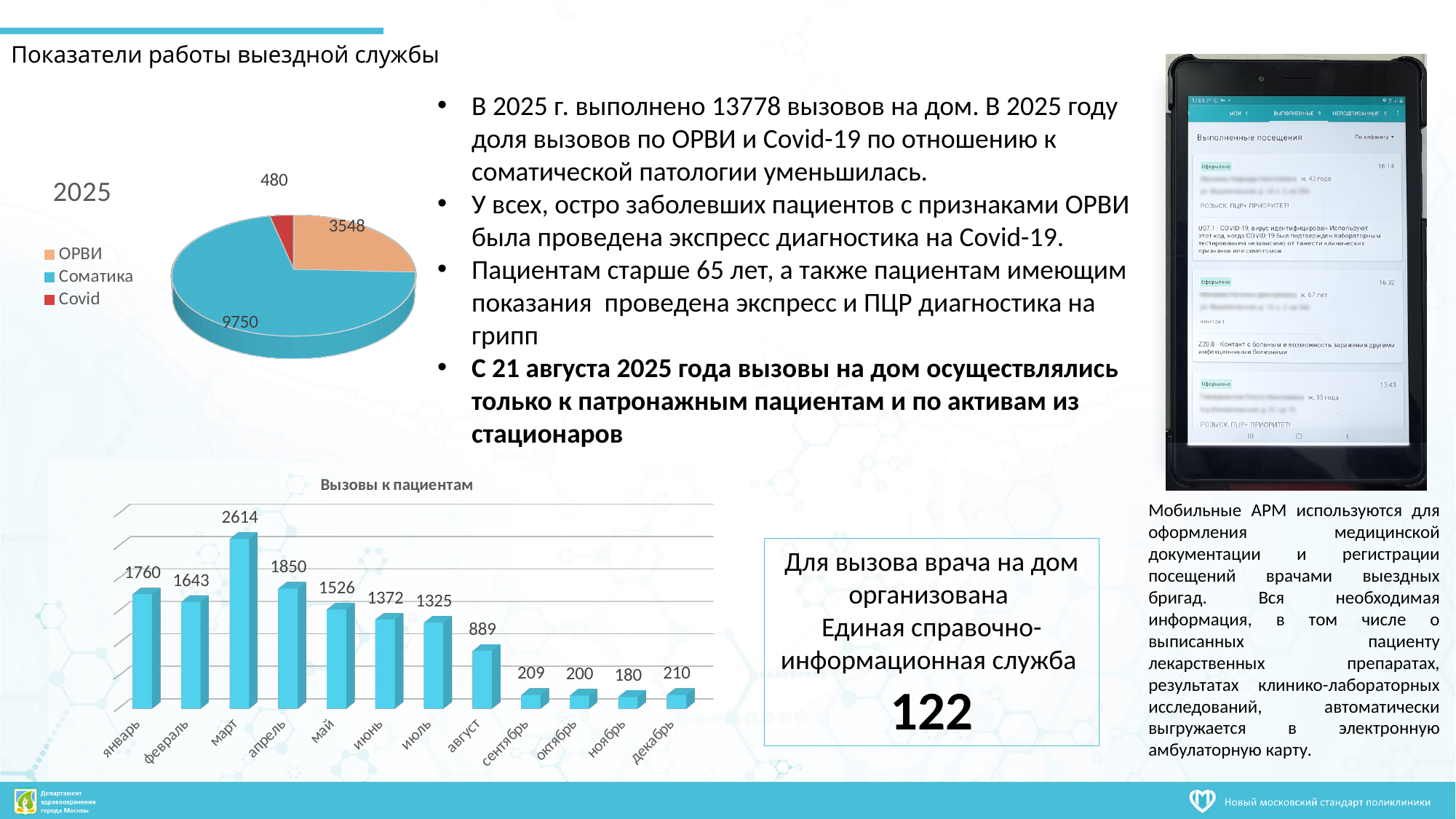
In the chart titled Вызовы к пациентам, which month has the highest value? март In the chart titled Вызовы к пациентам, what is the value for март? 2614 In the chart titled Вызовы к пациентам, what is the difference between the values for март and апрель? 764 In the chart titled Вызовы к пациентам, what is the value for август? 889 In the chart titled Вызовы к пациентам, which month has the lowest value? ноябрь What kind of chart is the chart titled Вызовы к пациентам? bar chart In the pie chart titled 2025, which category has the largest slice? Соматика In the pie chart titled 2025, how many categories does the legend list? 3 In the pie chart titled 2025, what is the value for Covid? 480 In the pie chart titled 2025, what is the difference between the ОРВИ and Covid values? 3068 In the chart titled Вызовы к пациентам, how many months are plotted? 12 In the pie chart titled 2025, what is the value for Соматика? 9750